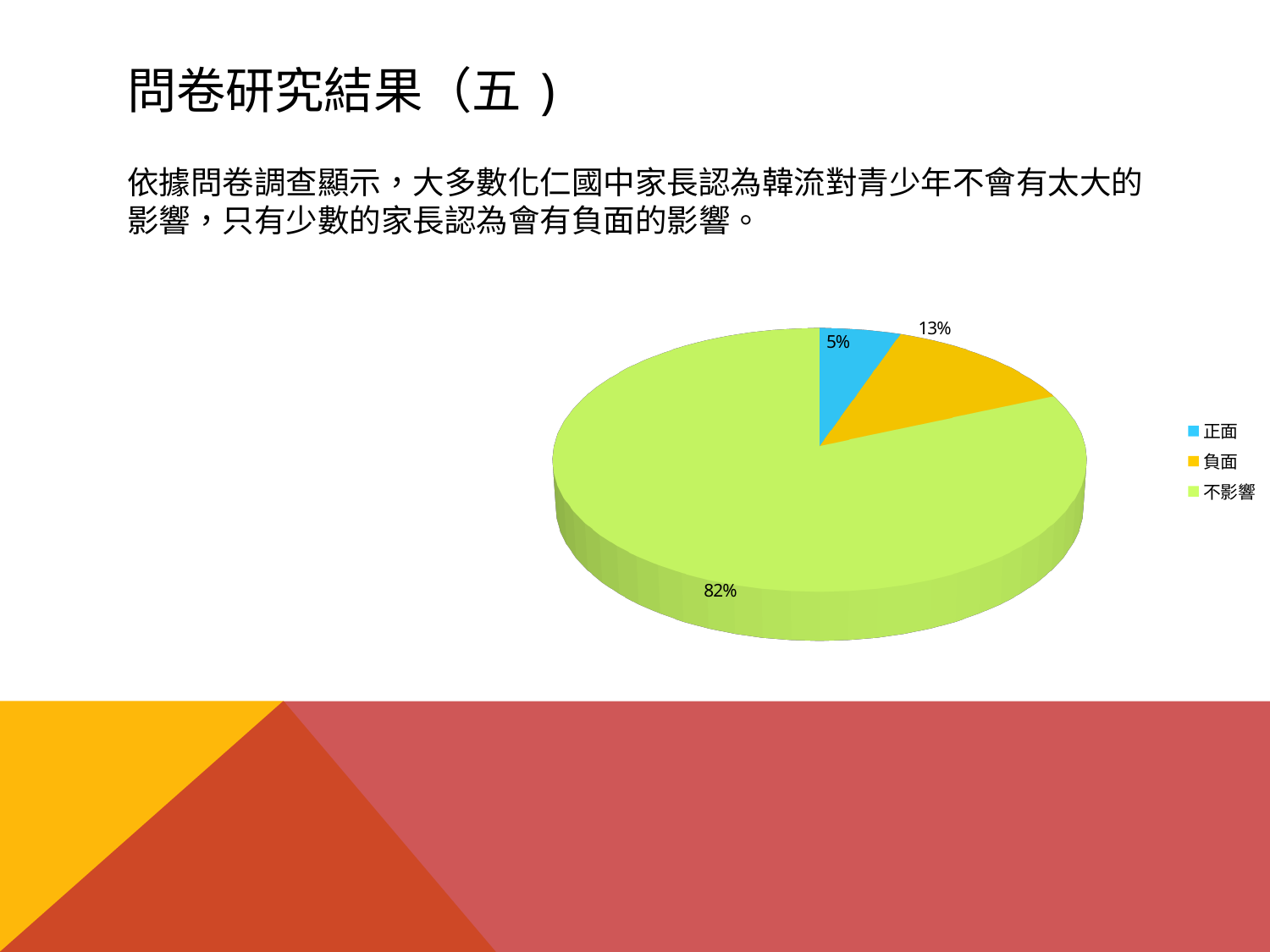
How many categories does the pie chart show? 3 How many entries does the legend list? 3 What share of the pie does 不影響 take? 82% Which category has the largest slice of the pie? 不影響 What share of the pie does 負面 take? 13% Which is larger, the slice for 負面 or the slice for 正面? 負面 Which category has the smallest slice of the pie? 正面 What is the difference in percentage points between 不影響 and 負面? 69 What is the difference in percentage points between 負面 and 正面? 8 What kind of chart is shown on the slide? pie chart What colour is the slice for 不影響? green What share of the pie does 正面 take? 5%